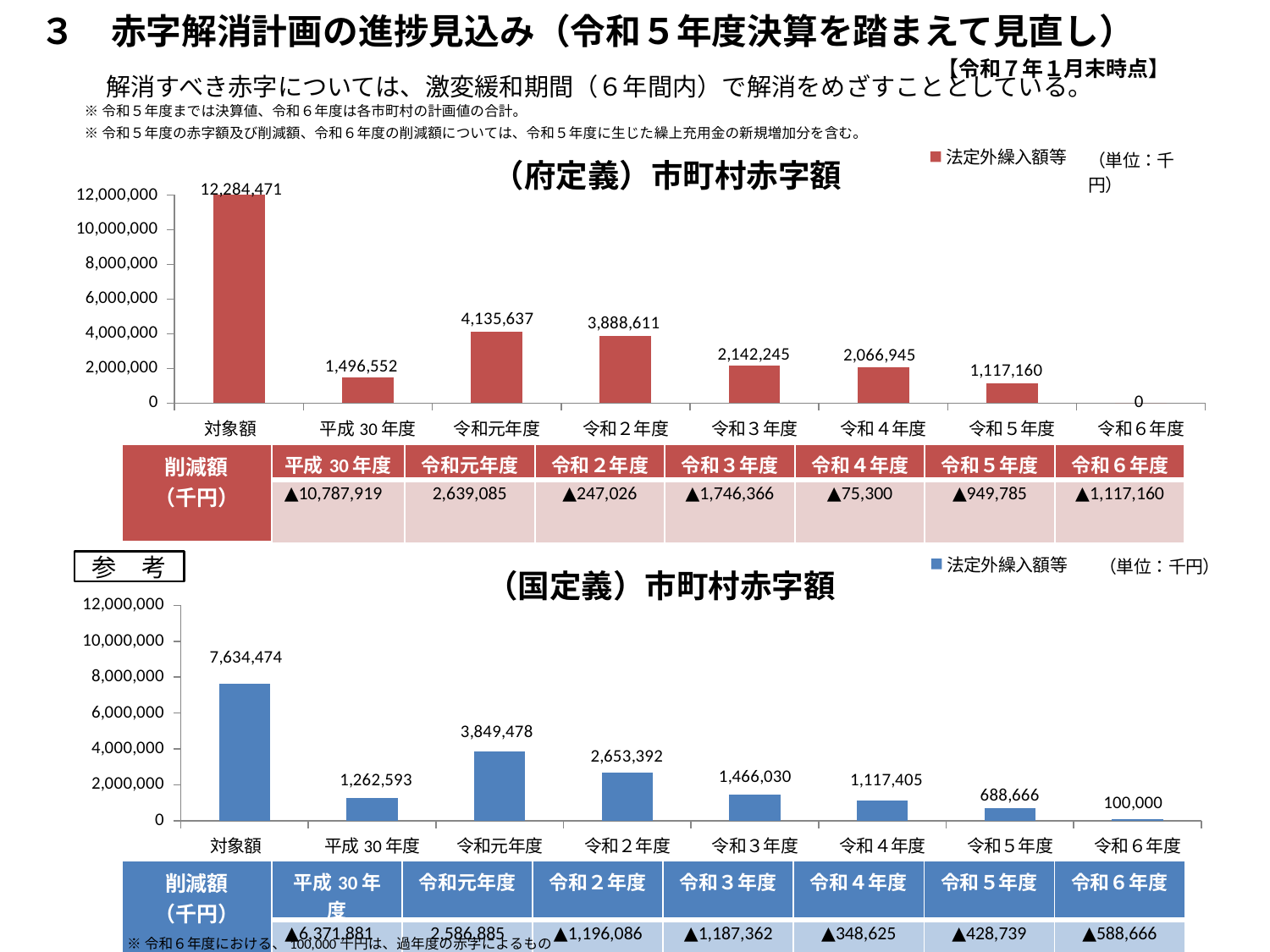
In the （国定義）市町村赤字額 chart, what is the value for 令和５年度? 688,666 In the （国定義）市町村赤字額 chart, which category has the highest value? 対象額 In the （府定義）市町村赤字額 chart, do the values rise or fall from 令和元年度 to 令和６年度? fall In the （国定義）市町村赤字額 chart, which is larger, the value for 令和元年度 or the value for 令和２年度? 令和元年度 In the （府定義）市町村赤字額 chart, what is the value for 対象額? 12,284,471 In the （国定義）市町村赤字額 chart, what is the value for 令和６年度? 100,000 In the （府定義）市町村赤字額 chart, which category has the lowest value? 令和６年度 In the （府定義）市町村赤字額 chart, what is the difference between the values for 令和３年度 and 令和４年度? 75,300 In the （府定義）市町村赤字額 chart, how many categories are shown on the x axis? 8 In the （府定義）市町村赤字額 chart, what is the value for 令和元年度? 4,135,637 In the （国定義）市町村赤字額 chart, what is the difference between the values for 令和２年度 and 令和３年度? 1,187,362 What kind of chart is the （国定義）市町村赤字額 chart? bar chart